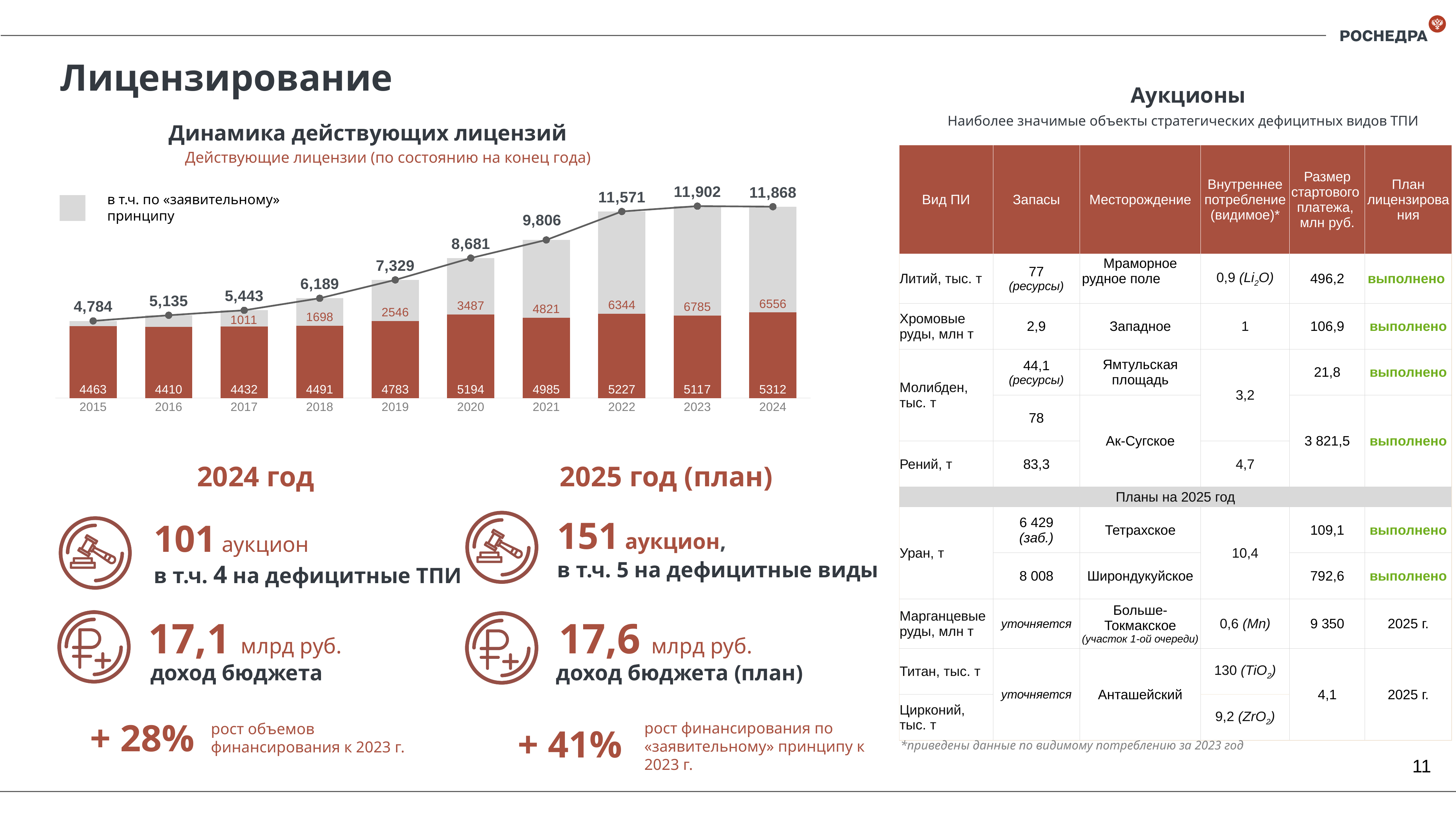
Which year has the lowest total number of active licences? 2015 What kind of chart is used to show the dynamics of active licences? Stacked bar chart with a line By how much did the total number of active licences increase from 2022 to 2023? 331 What is the value of the grey segment (по «заявительному» принципу) for 2022? 6344 Do the total values rise or fall from 2015 to 2023? Rise What is the difference between the red segment values for 2024 and 2023? 195 What is the total number of active licences shown for 2024? 11,868 Which year has the highest total number of active licences? 2023 What is the total of the stacked bar for 2020? 8,681 What is the value of the red (lower) segment for 2019? 4783 How many years are shown on the x axis of the chart? 10 Which year has the larger grey segment (по «заявительному» принципу): 2023 or 2024? 2023